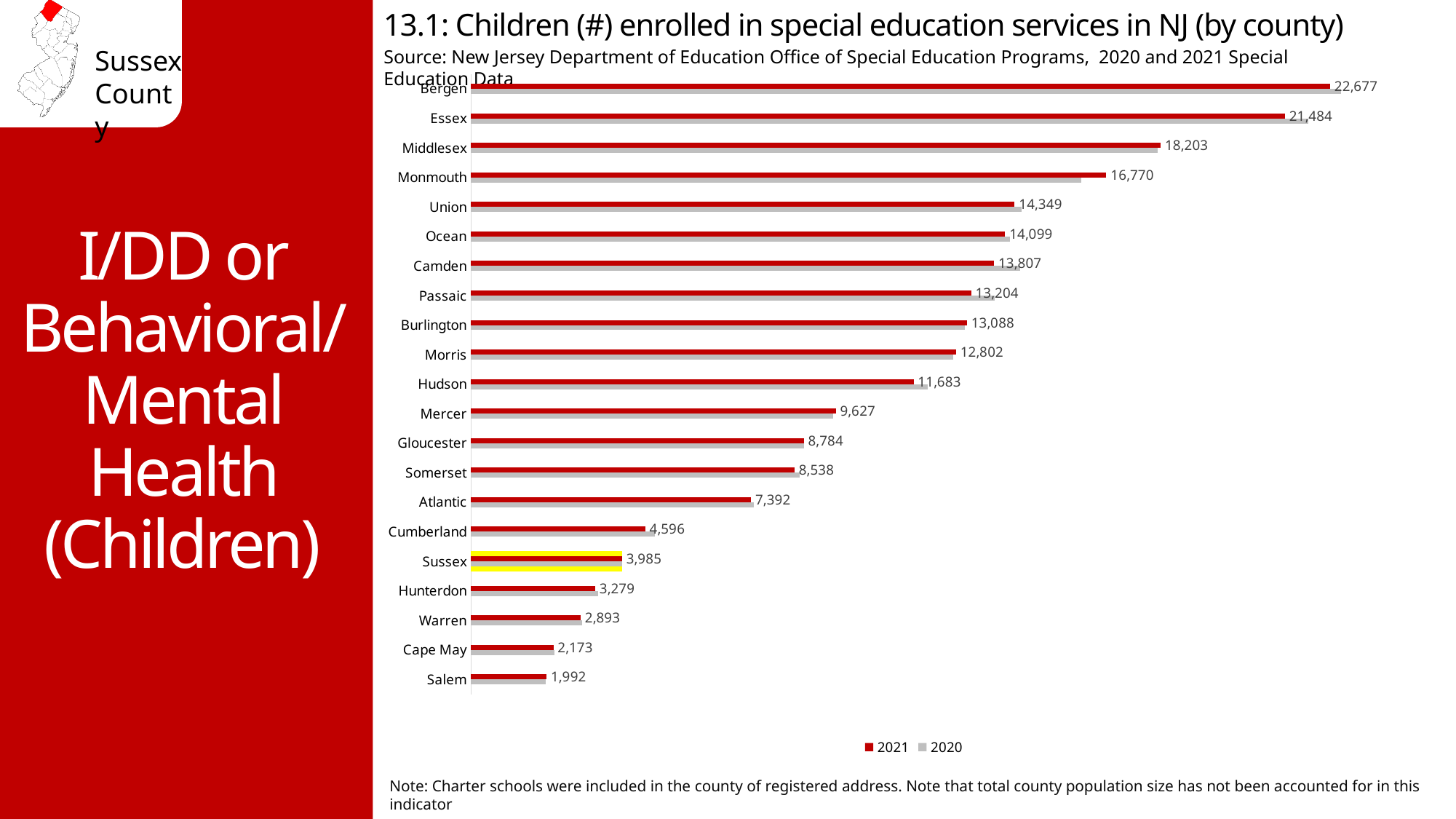
Which county has a larger 2021 value, Cumberland or Sussex? Cumberland What is the difference between the 2021 values for Bergen and Essex? 1,193 Which county has the lowest 2021 value? Salem What is the difference between the 2021 values for Sussex and Warren? 1,092 What type of chart is shown on the slide? bar chart What is the 2021 value for Hunterdon County? 3,279 How many series does the legend list? 2 What are the two series shown in the legend? 2021 and 2020 Which county has the highest 2021 value? Bergen How many counties are listed on the chart? 21 What is the 2021 value for Bergen County? 22,677 What is the 2021 number of children enrolled in special education services in Sussex County? 3,985